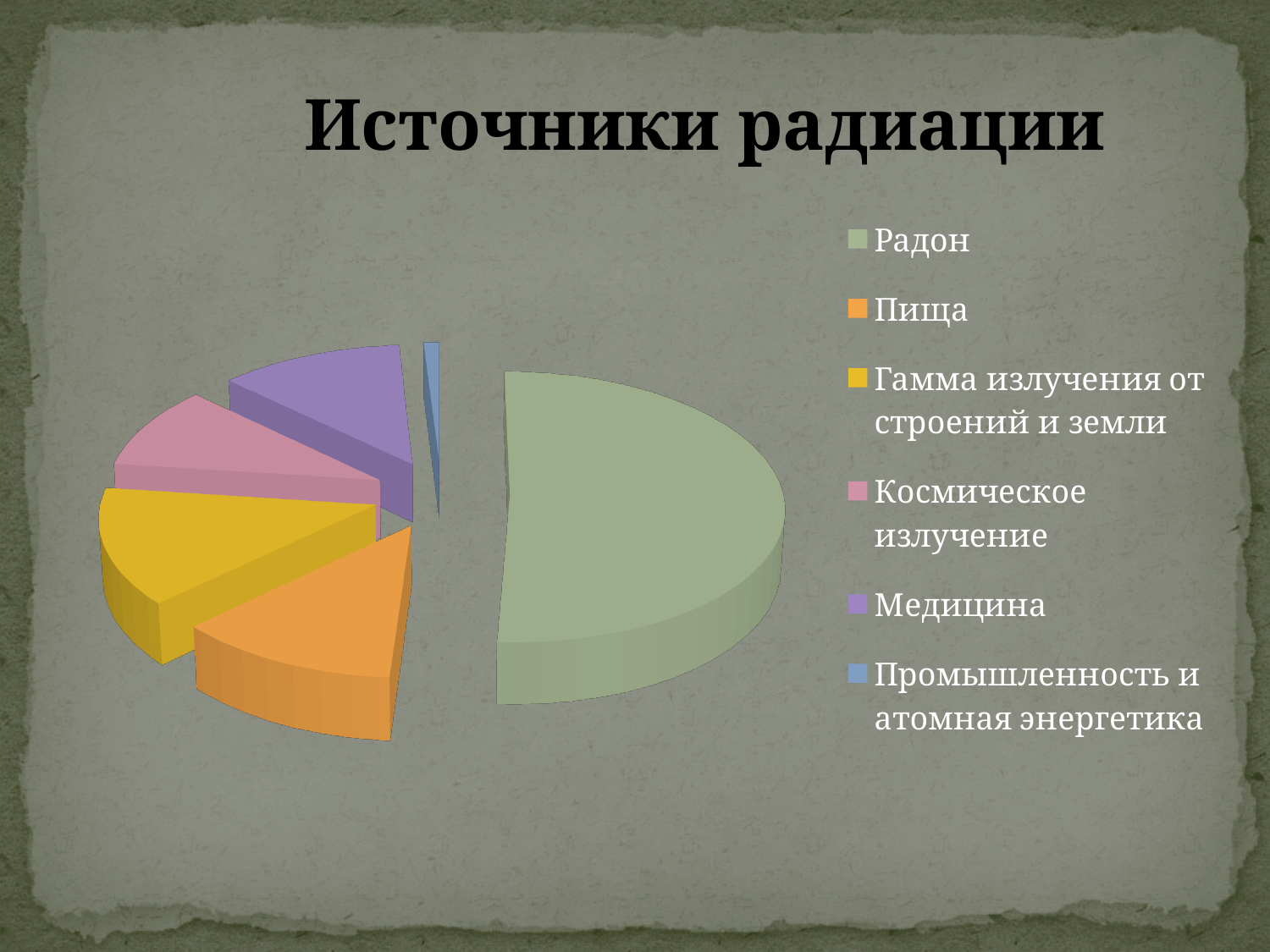
Which slice is larger: Медицина or Промышленность и атомная энергетика? Медицина How many categories (slices) does the pie chart have? 6 Which source of radiation has the largest slice of the pie? Радон Which source of radiation has the smallest slice of the pie? Промышленность и атомная энергетика What kind of chart is shown on the slide? pie chart Which slice is larger: Радон or Пища? Радон Which slice is larger: Гамма излучения от строений и земли or Промышленность и атомная энергетика? Гамма излучения от строений и земли How many entries does the legend list? 6 Which colour represents Пища in the pie chart? orange What is the title of the chart on the slide? Источники радиации